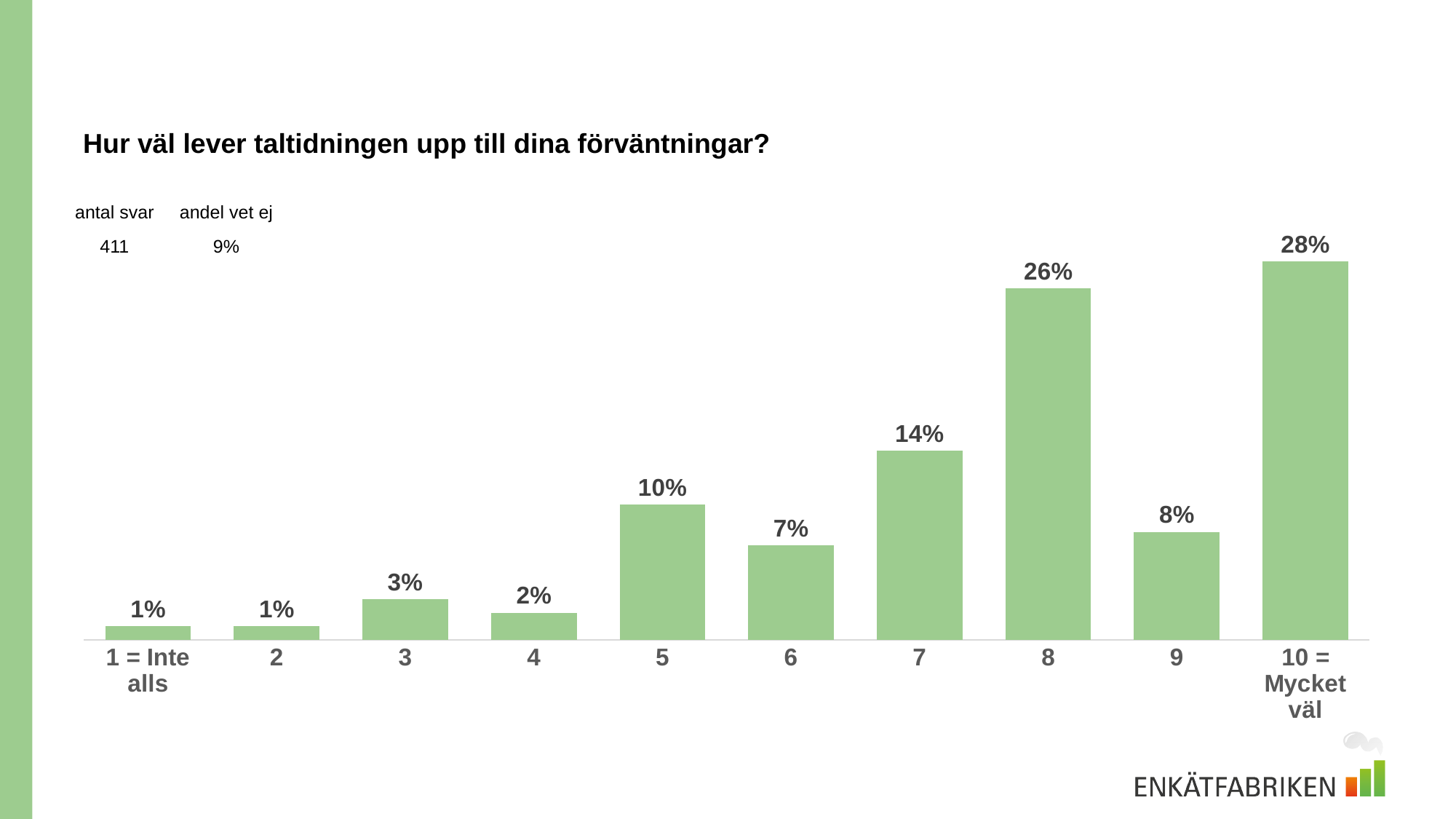
Which is larger, the value for category 6 or the value for category 7? 7 What is the value for '10 = Mycket väl'? 28% What is the value for category 8? 26% Which category has the highest value? 10 = Mycket väl What is the difference between the values for category 7 and category 5? 4% How many categories are shown on the x axis? 10 What is the 'antal svar' shown on the slide? 411 What kind of chart is shown on the slide? Bar chart What is the value for category 5? 10% What is the value for category 4? 2% What is the title of the chart? Hur väl lever taltidningen upp till dina förväntningar? What is the difference between the values for category 8 and category 9? 18%